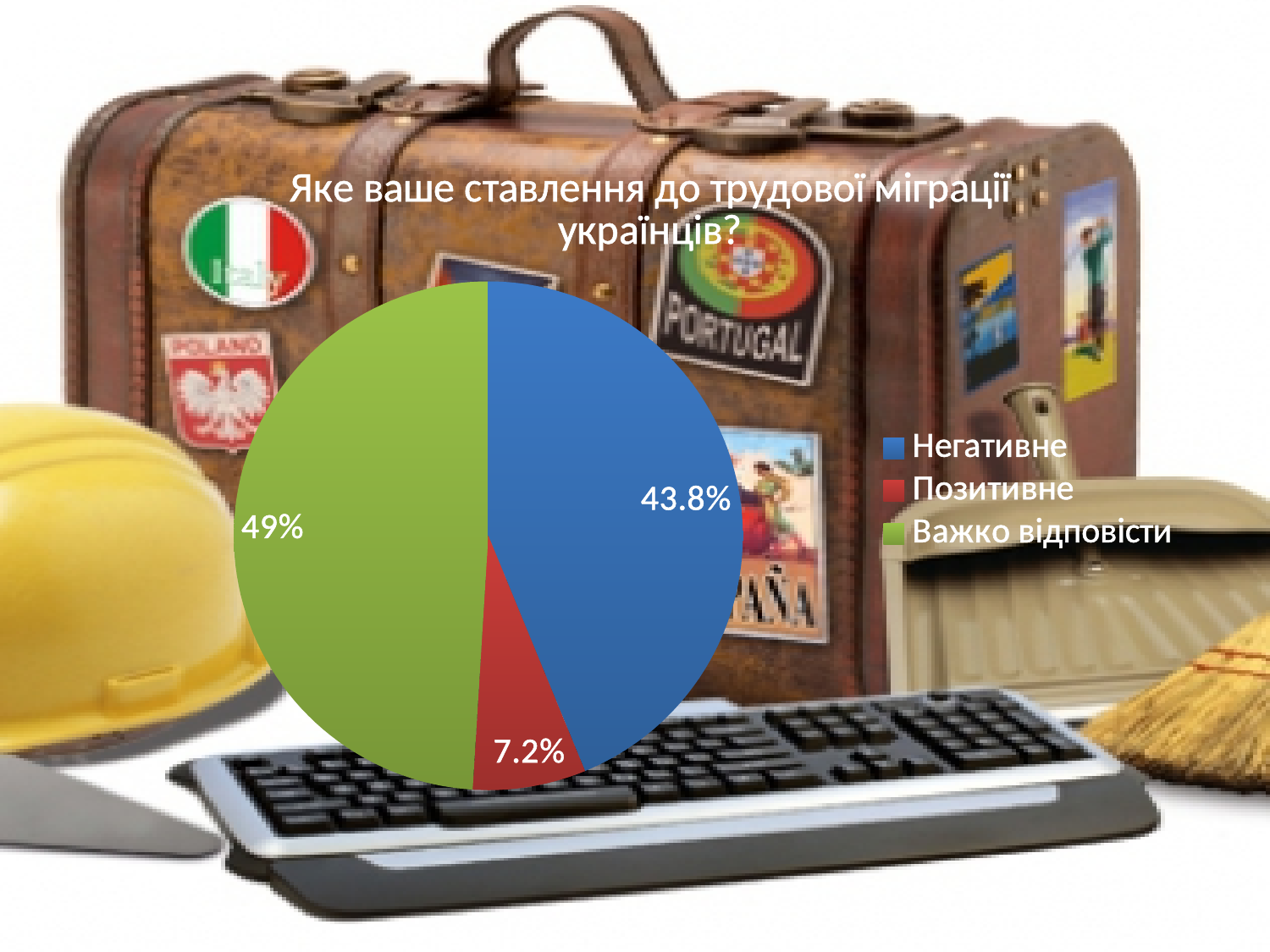
How many slices does the pie chart have? 3 Which colour represents "Позитивне" in the pie chart? red What percentage of respondents answered "Важко відповісти"? 49% What is the difference in percentage points between "Негативне" and "Позитивне"? 36.6 What kind of chart is shown on the slide? pie chart What percentage of respondents answered "Позитивне"? 7.2% Which response has the largest share of the pie? Важко відповісти What percentage of respondents answered "Негативне"? 43.8% What is the title of the chart? Яке ваше ставлення до трудової міграції українців? Which is larger, the share for "Негативне" or the share for "Важко відповісти"? Важко відповісти Which response has the smallest share of the pie? Позитивне How many entries does the legend list? 3